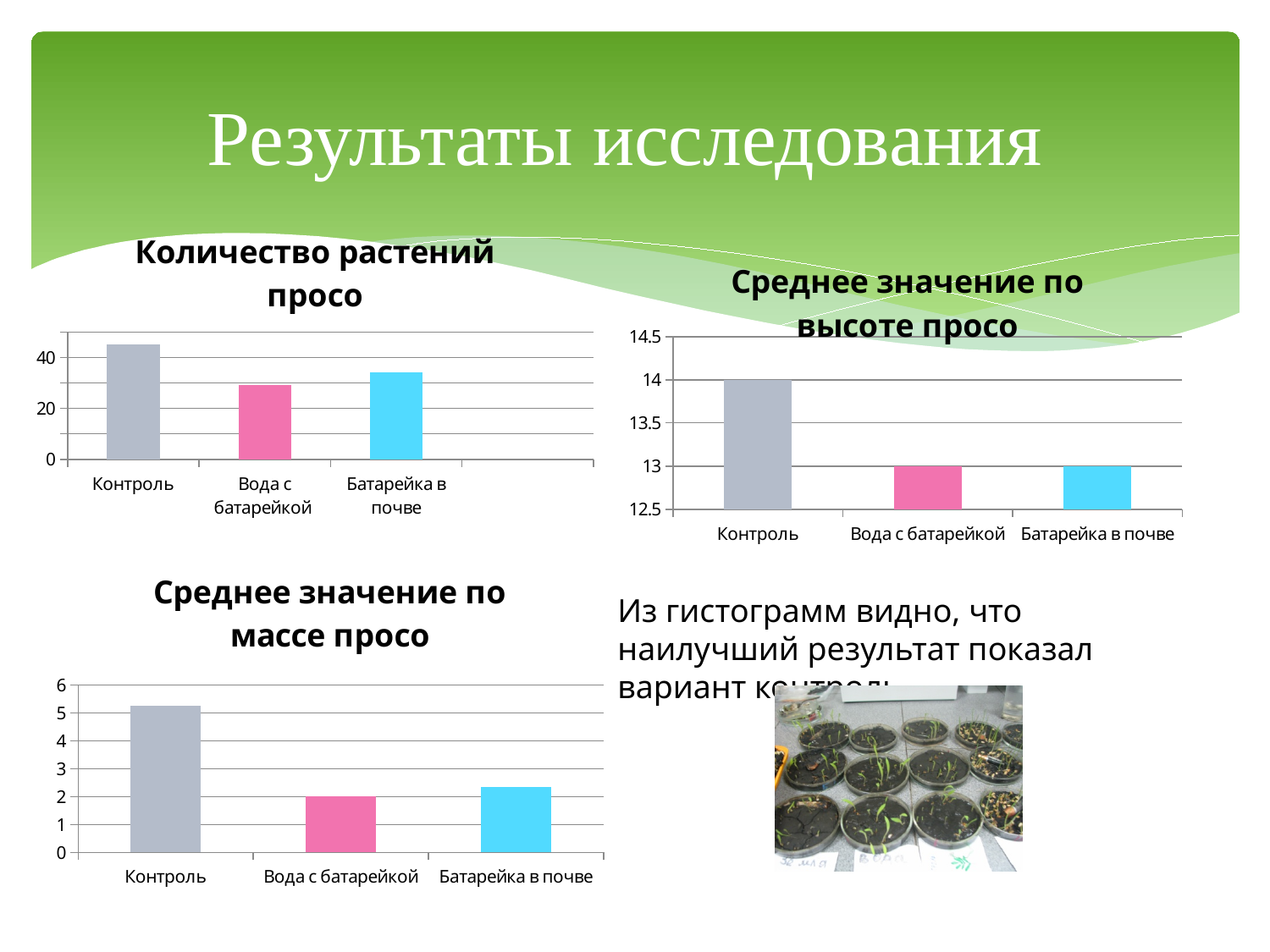
In the chart titled 'Среднее значение по высоте просо', what is the difference between the values for Контроль and Батарейка в почве? 1 In the chart titled 'Среднее значение по высоте просо', what is the value for Контроль? 14 In the chart titled 'Среднее значение по массе просо', is the value for Контроль greater or less than 5? greater In the chart titled 'Количество растений просо', which is larger, the value for Батарейка в почве or the value for Вода с батарейкой? Батарейка в почве In the chart titled 'Количество растений просо', is the value for Контроль greater or less than 40? greater In the chart titled 'Среднее значение по высоте просо', what is the value for Вода с батарейкой? 13 In the chart titled 'Среднее значение по высоте просо', which category has the highest value? Контроль In the chart titled 'Количество растений просо', is the value for Вода с батарейкой greater or less than 20? greater How many categories are shown in the chart titled 'Количество растений просо'? 3 In the chart titled 'Среднее значение по массе просо', which category has the highest value? Контроль What kind of chart is the chart titled 'Среднее значение по массе просо'? bar chart